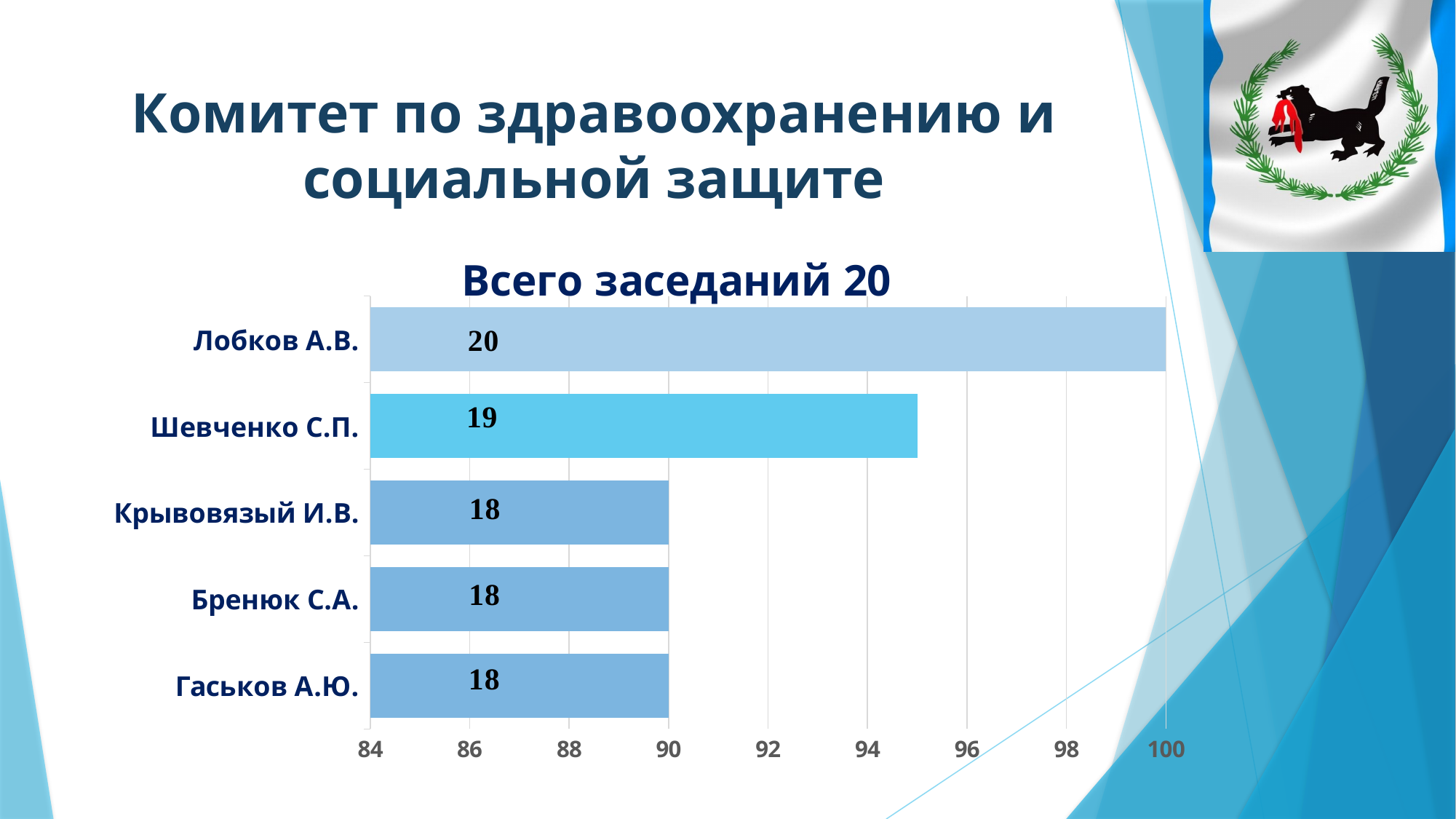
What kind of chart is shown on the slide? bar chart How many categories (deputies) are shown in the chart? 5 What axis value does the bar for Лобков А.В. reach? 100 What is the data label shown on the bar for Шевченко С.П.? 19 What is the data label shown on the bar for Гаськов А.Ю.? 18 What is the data label shown on the bar for Бренюк С.А.? 18 Which deputy has the longest bar in the chart? Лобков А.В. Which bar is longer, Шевченко С.П. or Крывовязый И.В.? Шевченко С.П. What is the data label shown on the bar for Лобков А.В.? 20 What is the difference between the data labels for Лобков А.В. and Крывовязый И.В.? 2 What is the chart's title? Всего заседаний 20 Is the bar for Шевченко С.П. greater or less than 94 on the axis? greater